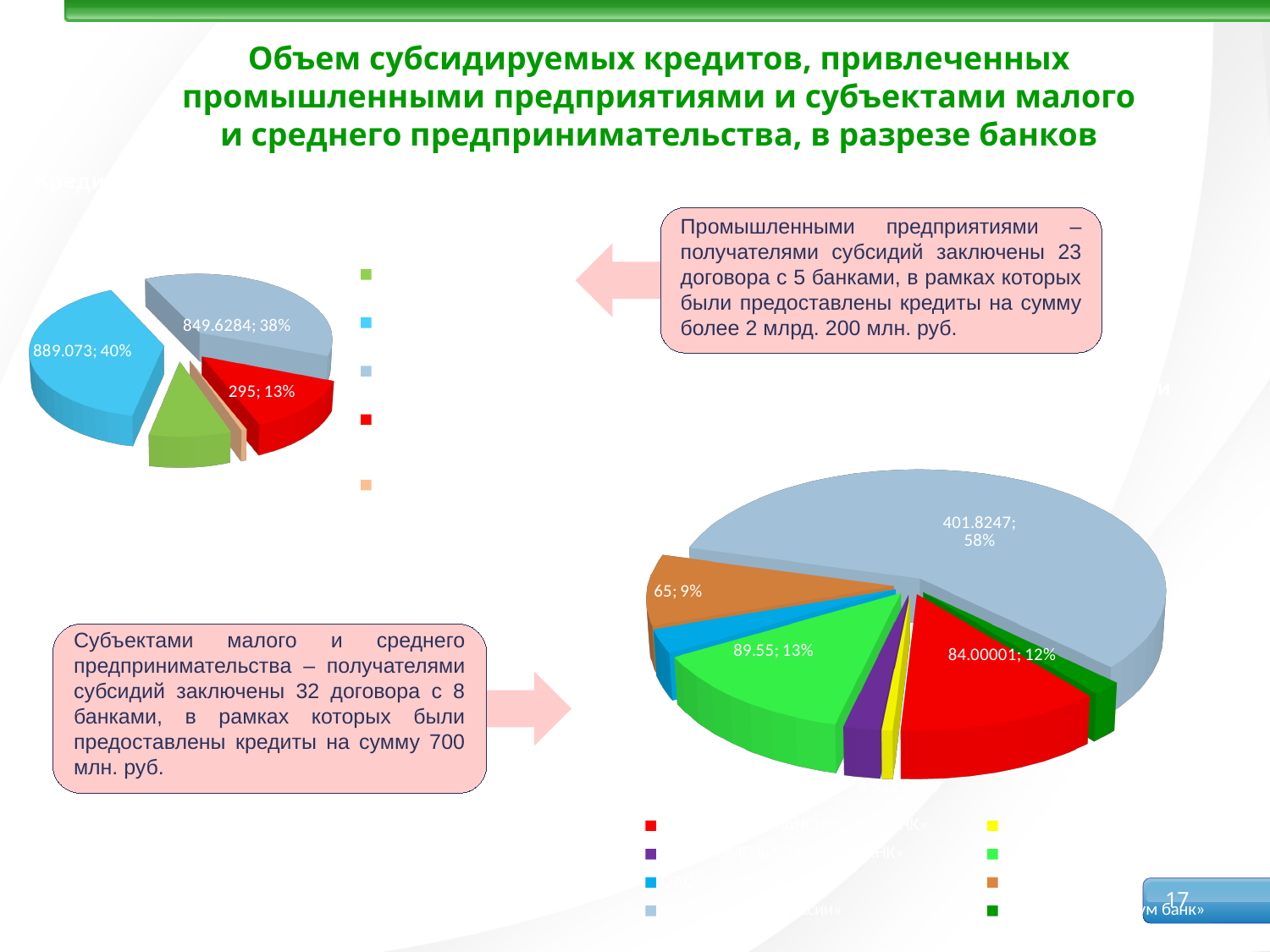
In the bottom-right pie chart, what value is printed on the bright green slice? 89.55 How many entries does the legend of the top-left pie chart list? 5 How many charts are shown on the slide? 2 In the bottom-right pie chart, which slice has the larger value: the bright green slice or the red slice? the bright green slice How many entries does the legend of the bottom-right pie chart list? 8 In the top-left pie chart, what is the difference between the value of the blue slice (889.073) and the light blue slice (849.6284)? 39.4446 What kind of chart is the chart in the top-left of the slide? pie chart In the bottom-right pie chart, what share does the brown slice have? 9% In the top-left pie chart, what share does the largest slice (the blue one) have? 40% In the top-left pie chart, what share is printed on the light blue slice? 38% In the top-left pie chart, what value is printed on the red slice? 295 In the bottom-right pie chart, what value is printed on the largest slice? 401.8247